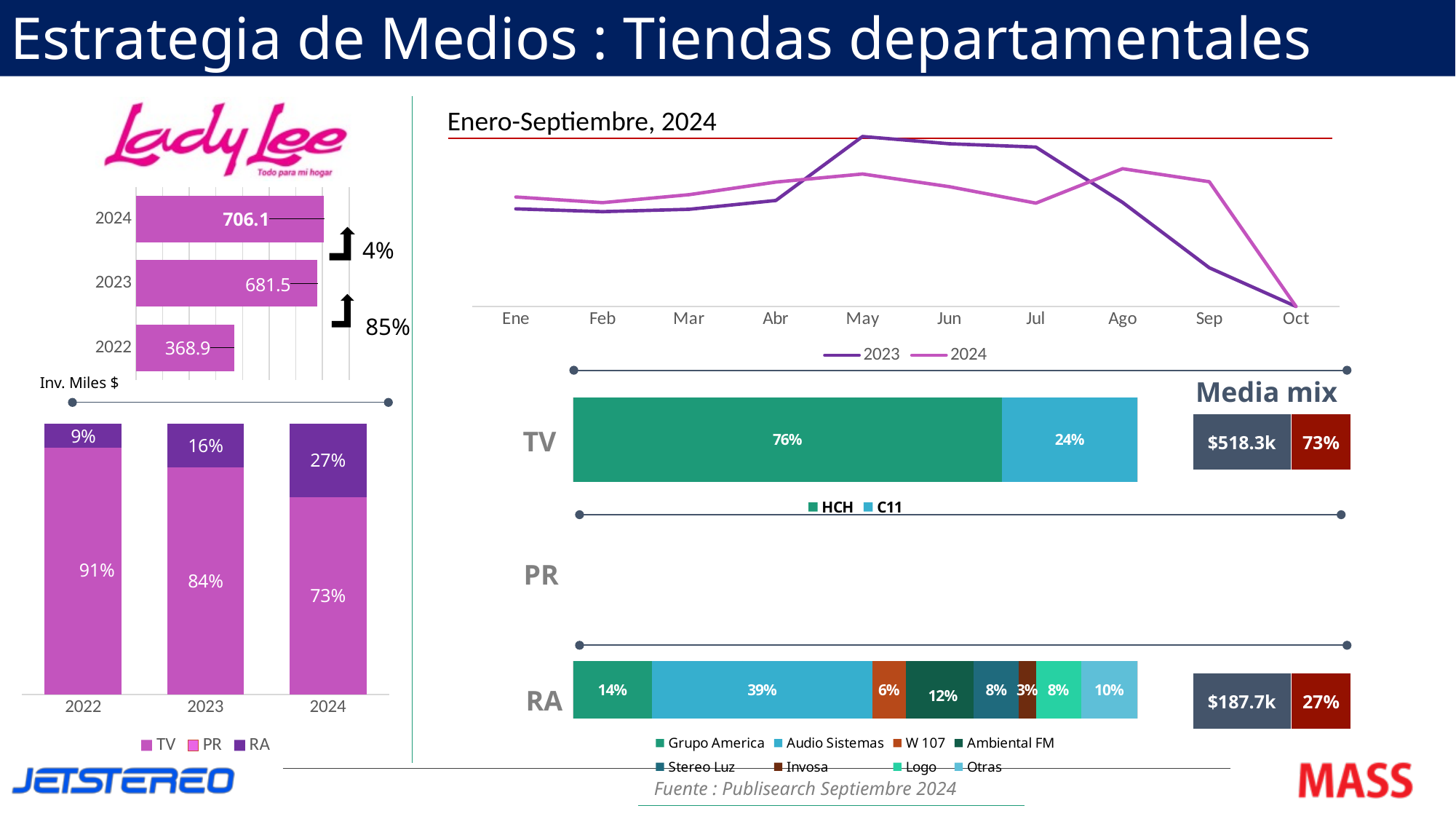
In the TV stacked bar on the right, what is the share for HCH? 76% In the investment bar chart under the Lady Lee logo, which year has the lowest value? 2022 In the investment bar chart under the Lady Lee logo, what is the value for 2022? 368.9 In the line chart titled Enero-Septiembre, 2024, which series is higher in May, 2023 or 2024? 2023 In the stacked bar chart at the bottom left, what is the RA share for 2024? 27% In the investment bar chart under the Lady Lee logo, what is the value for 2024? 706.1 In the line chart titled Enero-Septiembre, 2024, how many months are shown on the x axis? 10 In the stacked bar chart at the bottom left, how many series does the legend list? 3 In the RA stacked bar on the right, what is the share for Ambiental FM? 12% In the stacked bar chart at the bottom left, what is the TV share for 2023? 84% In the investment bar chart under the Lady Lee logo, what is the difference between the 2024 and 2023 values? 24.6 In the RA stacked bar on the right, which channel has the largest share? Audio Sistemas